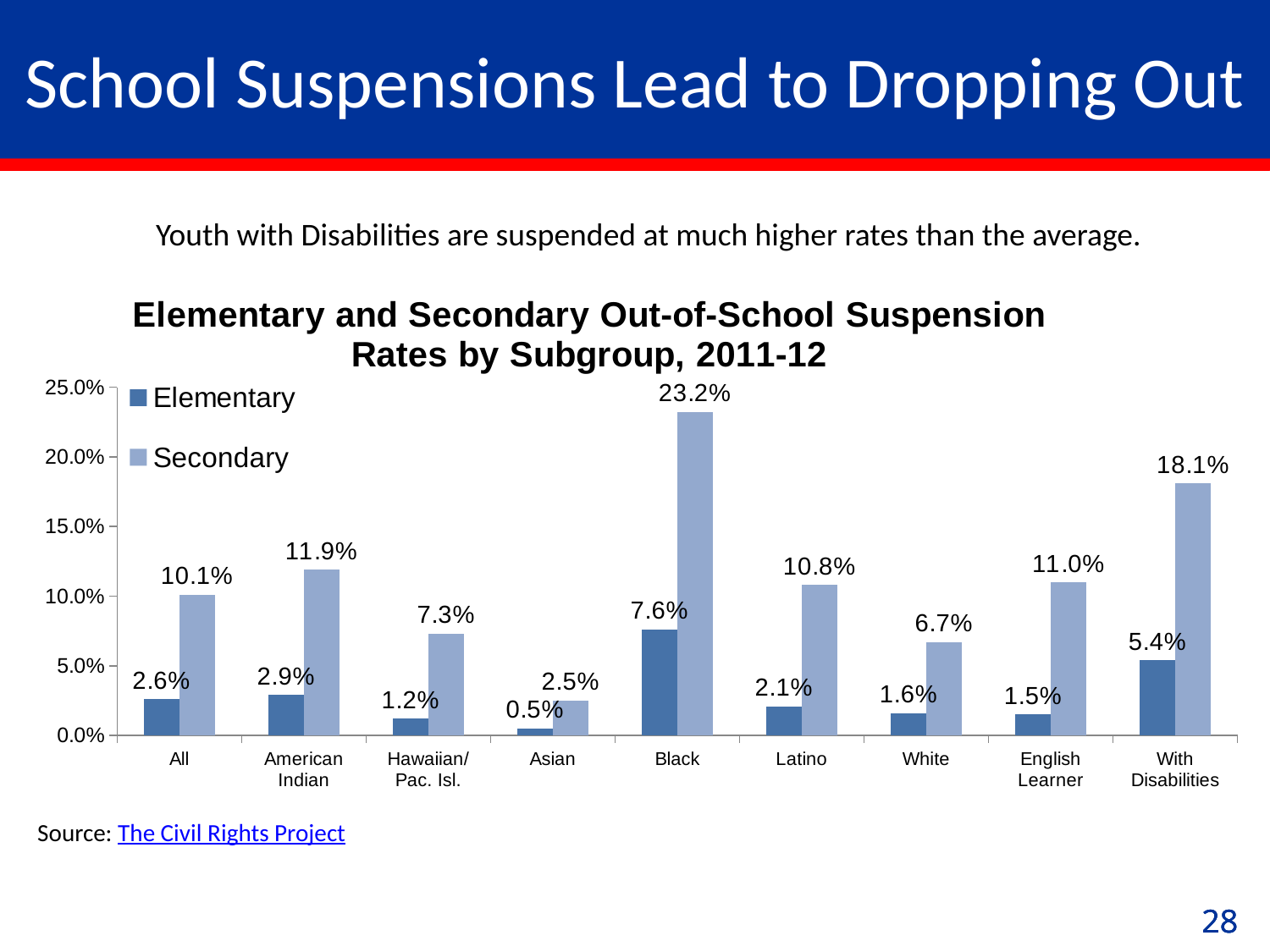
Which subgroup has the highest Secondary suspension rate? Black What is the difference between the Secondary rates for Black students and All students? 13.1% What is the title of the chart? Elementary and Secondary Out-of-School Suspension Rates by Subgroup, 2011-12 What kind of chart is shown on the slide? Bar chart What is the Secondary suspension rate for English Learner students? 11.0% How many subgroups are shown on the x axis? 9 Which is larger, the Secondary rate for Latino students or the Secondary rate for White students? Latino How many series does the legend list? 2 Which subgroup has the lowest Elementary suspension rate? Asian What is the Secondary suspension rate for Black students? 23.2% What is the Elementary suspension rate for students With Disabilities? 5.4% What is the difference between the Secondary and Elementary suspension rates for students With Disabilities? 12.7%